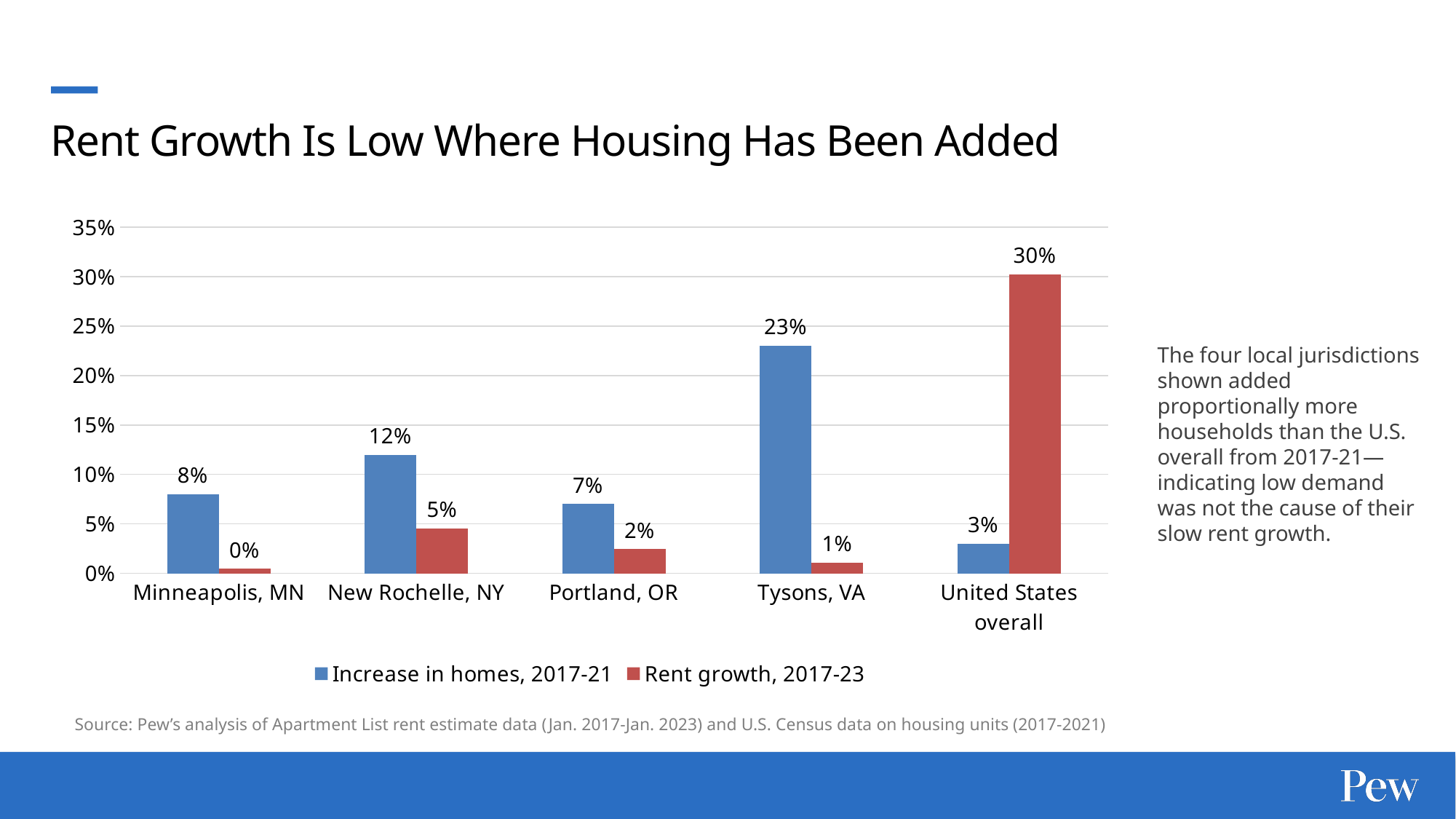
What is the increase in homes, 2017-21 for Tysons, VA? 23% Which category has the highest increase in homes, 2017-21? Tysons, VA What is the title of the slide? Rent Growth Is Low Where Housing Has Been Added Which is larger for Portland, OR: the increase in homes, 2017-21 or the rent growth, 2017-23? Increase in homes, 2017-21 What is the difference between the increase in homes, 2017-21 and the rent growth, 2017-23 for Tysons, VA? 22% What is the rent growth, 2017-23 for United States overall? 30% Is the rent growth, 2017-23 for United States overall greater or less than 25%? greater How many series does the legend list? 2 What is the rent growth, 2017-23 for New Rochelle, NY? 5% What kind of chart is shown on the slide? Bar chart Which category has the lowest rent growth, 2017-23? Minneapolis, MN How many categories are shown on the x axis? 5